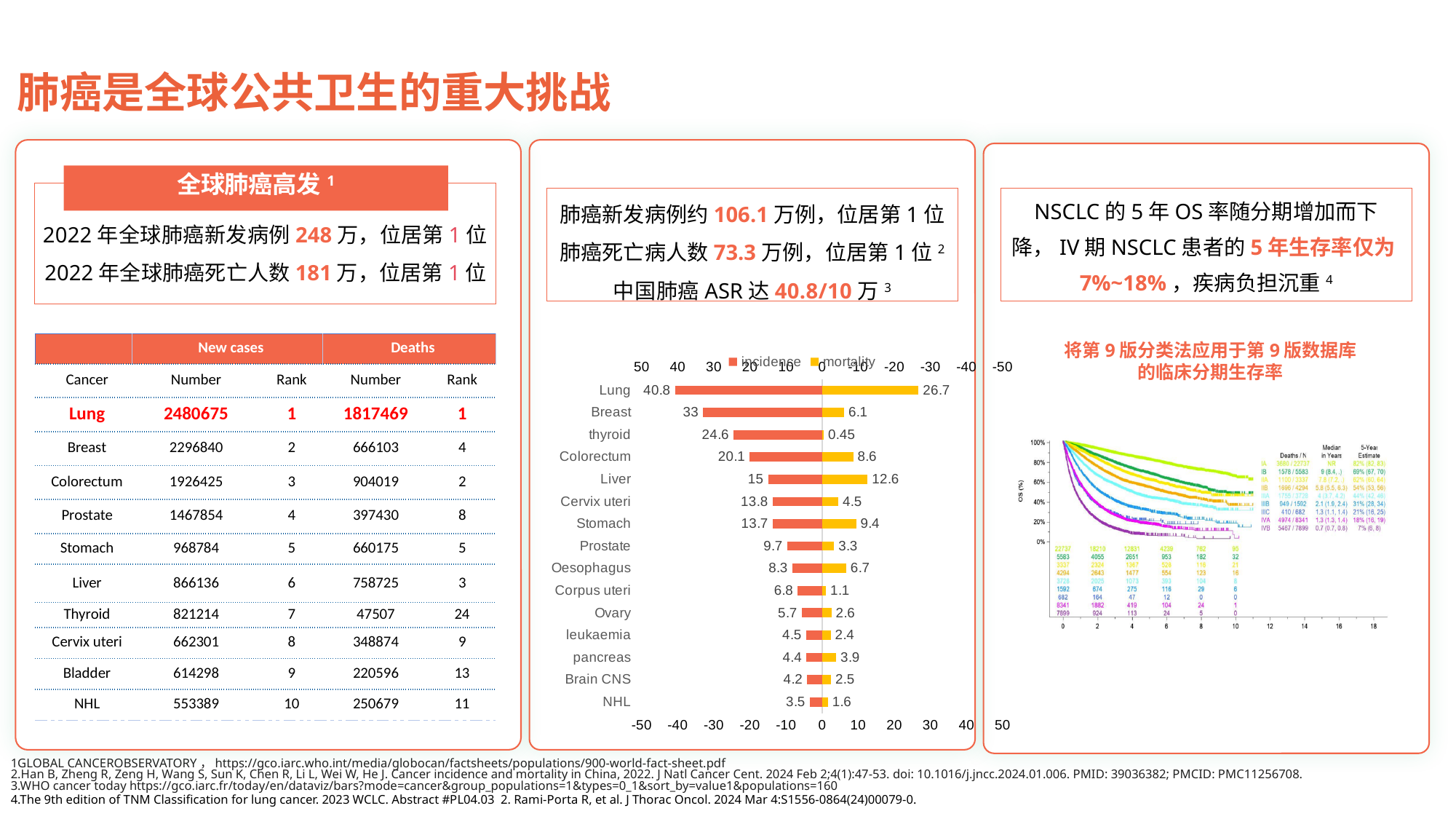
In the bar chart in the middle panel, what is the difference between the incidence and mortality values for Lung? 14.1 In the bar chart in the middle panel, which cancer has the highest incidence value? Lung What are the two series named in the legend of the bar chart in the middle panel? incidence and mortality In the bar chart in the middle panel, which is larger: the mortality value for Stomach or the mortality value for Colorectum? Stomach In the bar chart in the middle panel, what is the mortality value for thyroid? 0.45 In the bar chart in the middle panel, what is the incidence value for Lung? 40.8 In the bar chart in the middle panel, what is the mortality value for Liver? 12.6 What kind of chart is shown in the middle panel? Bar chart In the bar chart in the middle panel, which cancer has the lowest mortality value? thyroid How many series does the legend of the bar chart in the middle panel list? 2 In the bar chart in the middle panel, is the incidence value for Breast greater or less than 30? greater How many cancer types are listed in the bar chart in the middle panel? 15